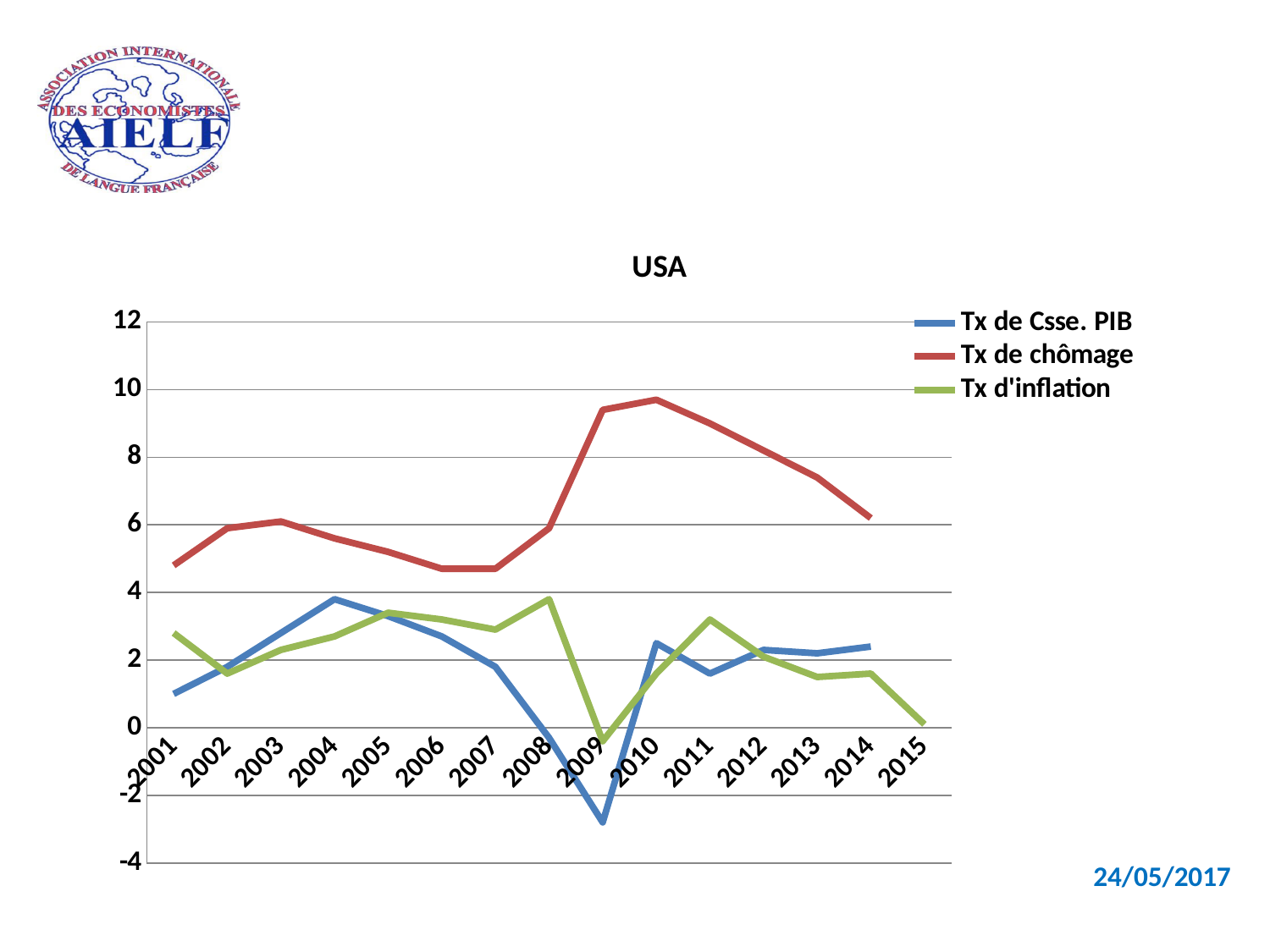
What type of chart is shown on the slide? line chart Is the value of Tx de chômage in 2010 greater or less than 8? greater Is the value of Tx de Csse. PIB in 2009 greater or less than -2? less What colour is the line for Tx de chômage? red In which year does Tx de chômage reach its highest value? 2010 In 2009, which is larger: Tx de chômage or Tx d'inflation? Tx de chômage How many years are shown along the x axis? 15 What is the title of the chart? USA How many series does the legend list? 3 Does Tx de chômage rise or fall from 2010 to 2014? fall Is the value of Tx d'inflation in 2008 greater or less than 2? greater In which year does Tx de Csse. PIB reach its lowest value? 2009